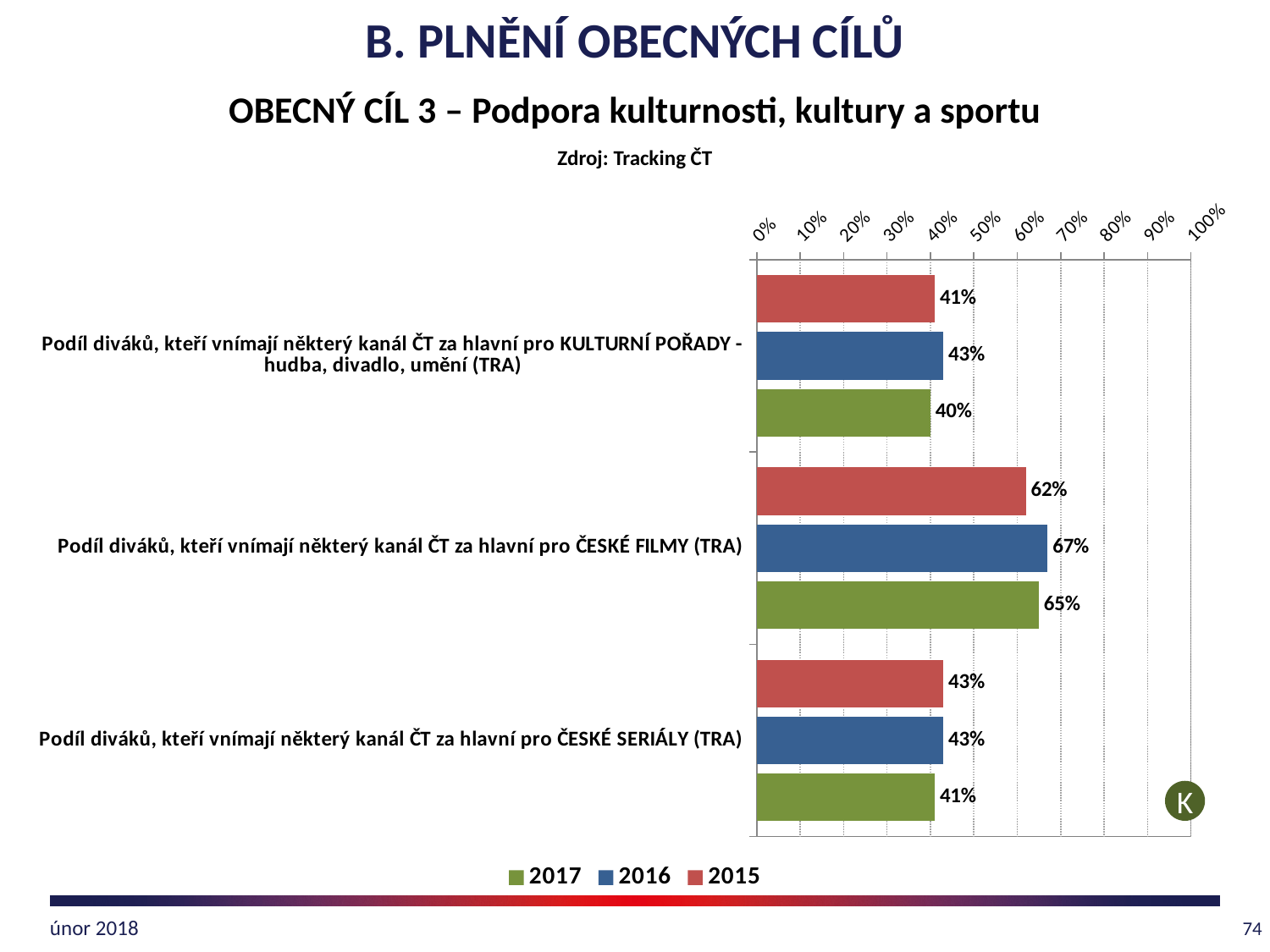
How many categories are shown on the chart? 3 Is the 2015 value for ČESKÉ FILMY (TRA) greater or less than 50%? greater What is the difference between the 2016 and 2015 values for ČESKÉ FILMY (TRA)? 5% Which colour represents the 2017 series in the legend? green Which category has the highest 2016 value? ČESKÉ FILMY (TRA) What kind of chart is shown on the slide? bar chart Which category has the lowest 2017 value? KULTURNÍ POŘADY - hudba, divadlo, umění (TRA) What is the 2017 value for ČESKÉ FILMY (TRA)? 65% For ČESKÉ SERIÁLY (TRA), which is larger: the 2016 value or the 2017 value? 2016 What is the 2015 value for ČESKÉ SERIÁLY (TRA)? 43% What is the 2016 value for KULTURNÍ POŘADY - hudba, divadlo, umění (TRA)? 43% How many series does the legend list? 3